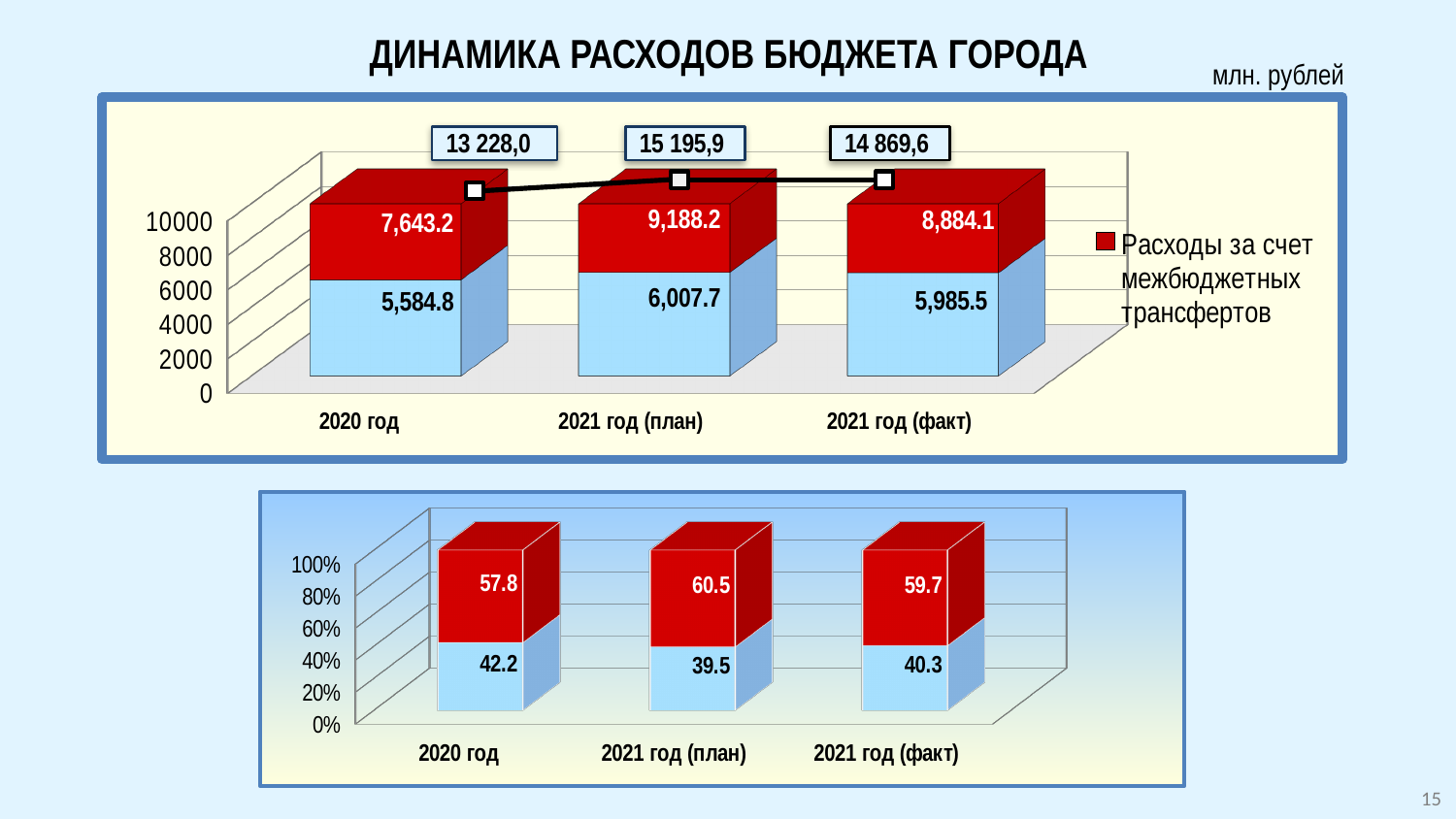
In the top chart, what is the value of the light blue segment for 2020 год? 5,584.8 In the top chart, which category has the highest value for the red series (Расходы за счет межбюджетных трансфертов)? 2021 год (план) In the top chart, what total is shown above the bar for 2021 год (факт)? 14 869,6 In the top chart, is the light blue value for 2021 год (план) greater or less than 6000? greater What kind of chart is the bottom chart? Stacked bar chart In the top chart, which category has the lowest total shown above the bars? 2020 год In the top chart, what is the value of the red series (Расходы за счет межбюджетных трансфертов) for 2021 год (план)? 9,188.2 How many categories are shown on the x axis of the top chart? 3 In the bottom chart, which is larger: the light blue value for 2020 год or for 2021 год (план)? 2020 год In the bottom chart, what is the red segment value for 2021 год (факт)? 59.7 In the top chart, what is the difference between the red series values for 2021 год (план) and 2021 год (факт)? 304.1 How many series does the legend of the top chart list? 1